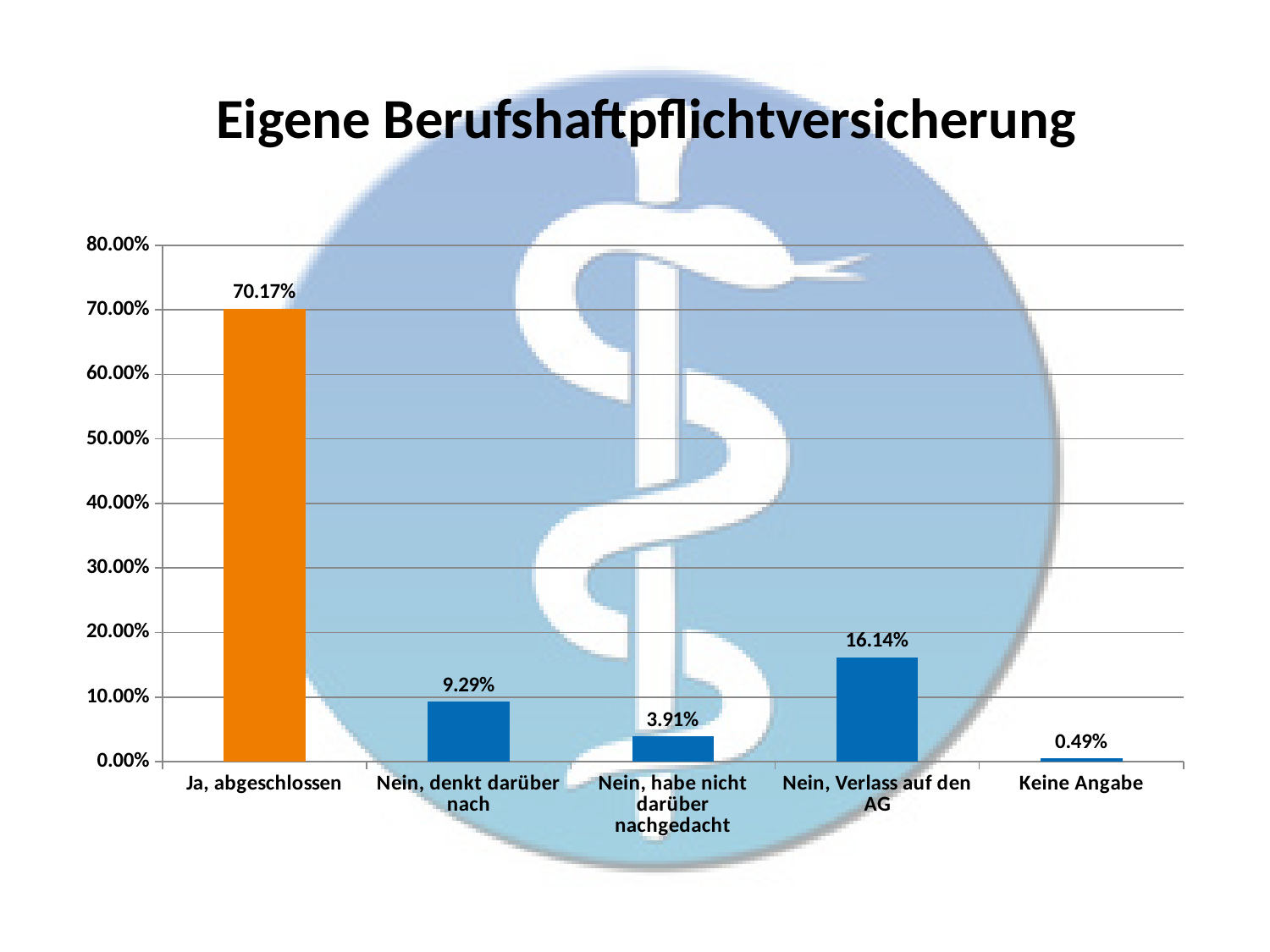
Which category has the highest value? Ja, abgeschlossen What is the value for "Ja, abgeschlossen"? 70.17% Which is larger: "Nein, denkt darüber nach" or "Nein, habe nicht darüber nachgedacht"? Nein, denkt darüber nach What is the value for "Keine Angabe"? 0.49% What is the difference between "Nein, Verlass auf den AG" and "Nein, denkt darüber nach"? 6.85% Is the value for "Nein, Verlass auf den AG" greater or less than 20.00%? less How many categories are shown on the x axis? 5 What is the title of the chart? Eigene Berufshaftpflichtversicherung What is the value for "Nein, Verlass auf den AG"? 16.14% What is the value for "Nein, habe nicht darüber nachgedacht"? 3.91% What kind of chart is shown on the slide? Bar chart Which category has the lowest value? Keine Angabe